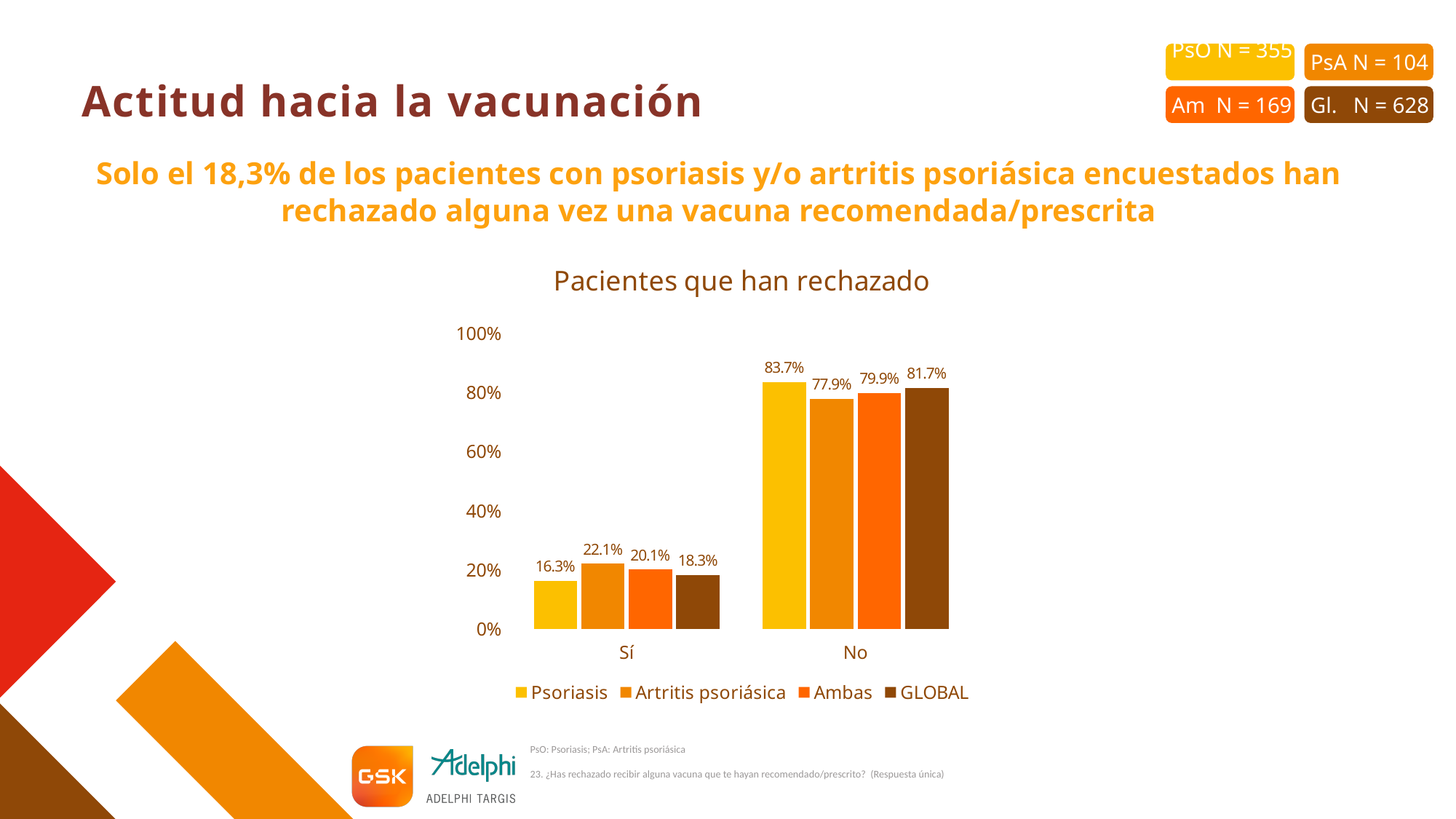
What is the value for Psoriasis in the Sí category? 16.3% What is the difference between the Psoriasis values for No and Sí? 67.4% What is the title of the chart? Pacientes que han rechazado Which series has the lowest value in the No category? Artritis psoriásica Which series has the highest value in the Sí category? Artritis psoriásica How many series does the legend list? 4 What is the value for Artritis psoriásica in the No category? 77.9% What is the value for GLOBAL in the Sí category? 18.3% What is the value for Ambas in the No category? 79.9% Is the value for Psoriasis in the No category greater or less than 80%? greater What kind of chart is shown on the slide? Bar chart Which is larger in the Sí category: the value for Ambas or the value for GLOBAL? Ambas